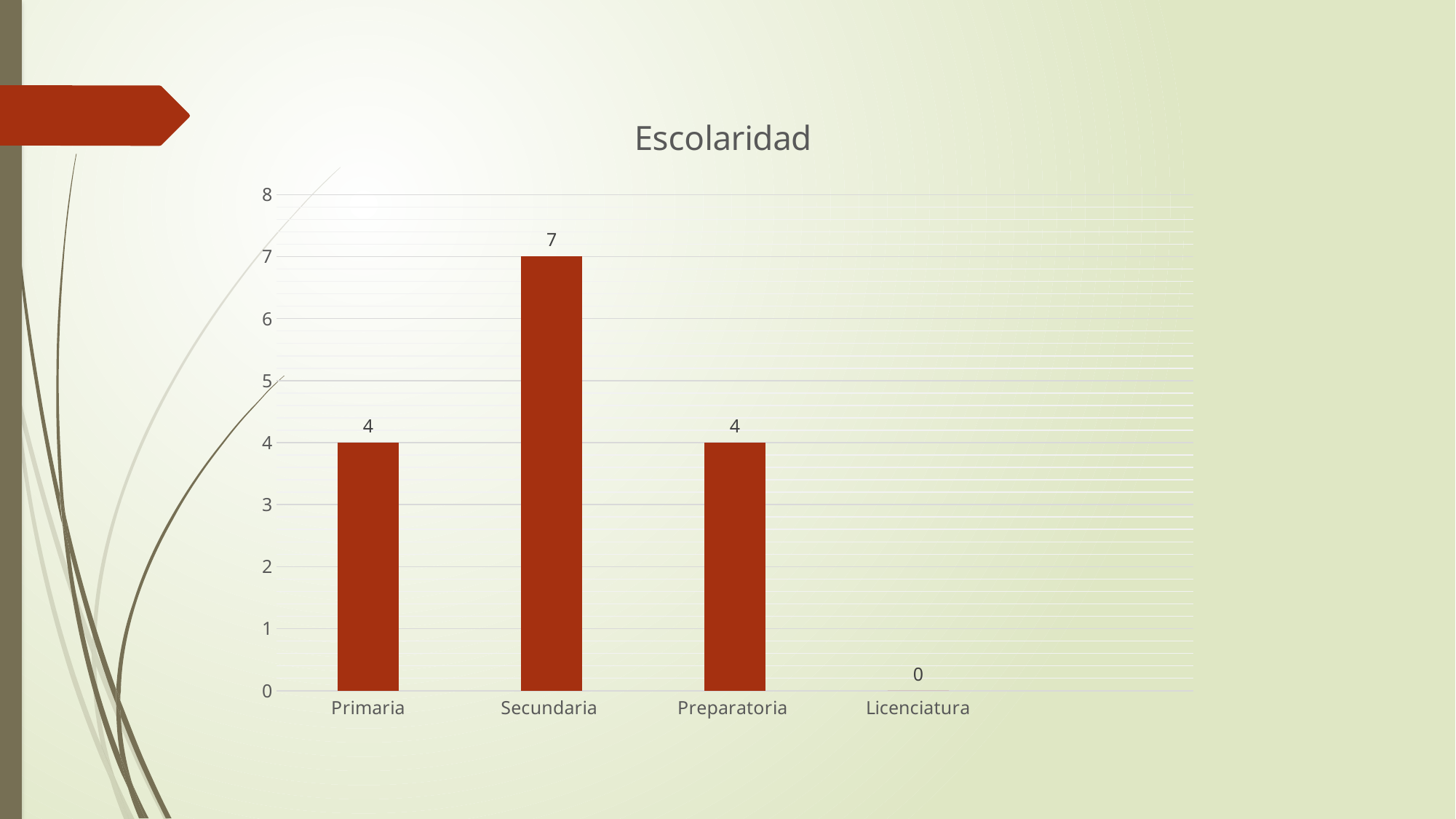
What is the value for Primaria? 4 Which category has the highest value? Secundaria What is the difference between the values for Secundaria and Preparatoria? 3 What is the total of the values for Primaria, Secundaria, Preparatoria and Licenciatura? 15 Is the value for Secundaria greater or less than 5? greater What is the value for Secundaria? 7 What kind of chart is shown on the slide? bar chart Which is larger, the value for Secundaria or the value for Primaria? Secundaria What is the value for Licenciatura? 0 What is the title of the chart? Escolaridad Which category has the lowest value? Licenciatura How many categories are shown on the x axis? 4